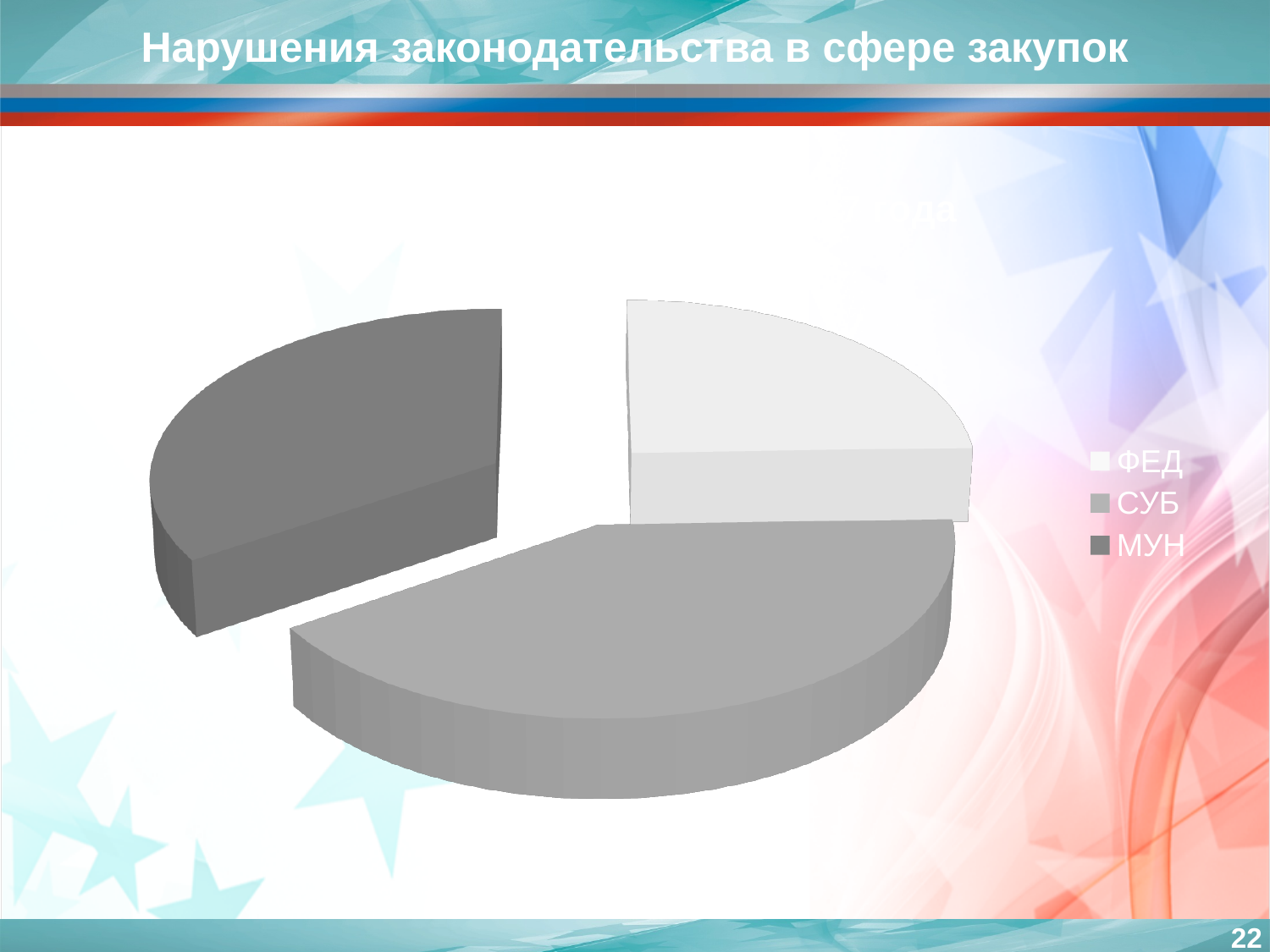
Which slice is larger, СУБ or МУН? СУБ What kind of chart is shown on the slide? pie chart How many slices does the pie chart have? 3 Which slice is larger, СУБ or ФЕД? СУБ Which category has the largest slice in the pie chart? СУБ Which legend entry is shown in the lightest colour? ФЕД What is the title of the slide containing the pie chart? Нарушения законодательства в сфере закупок How many entries does the legend of the pie chart list? 3